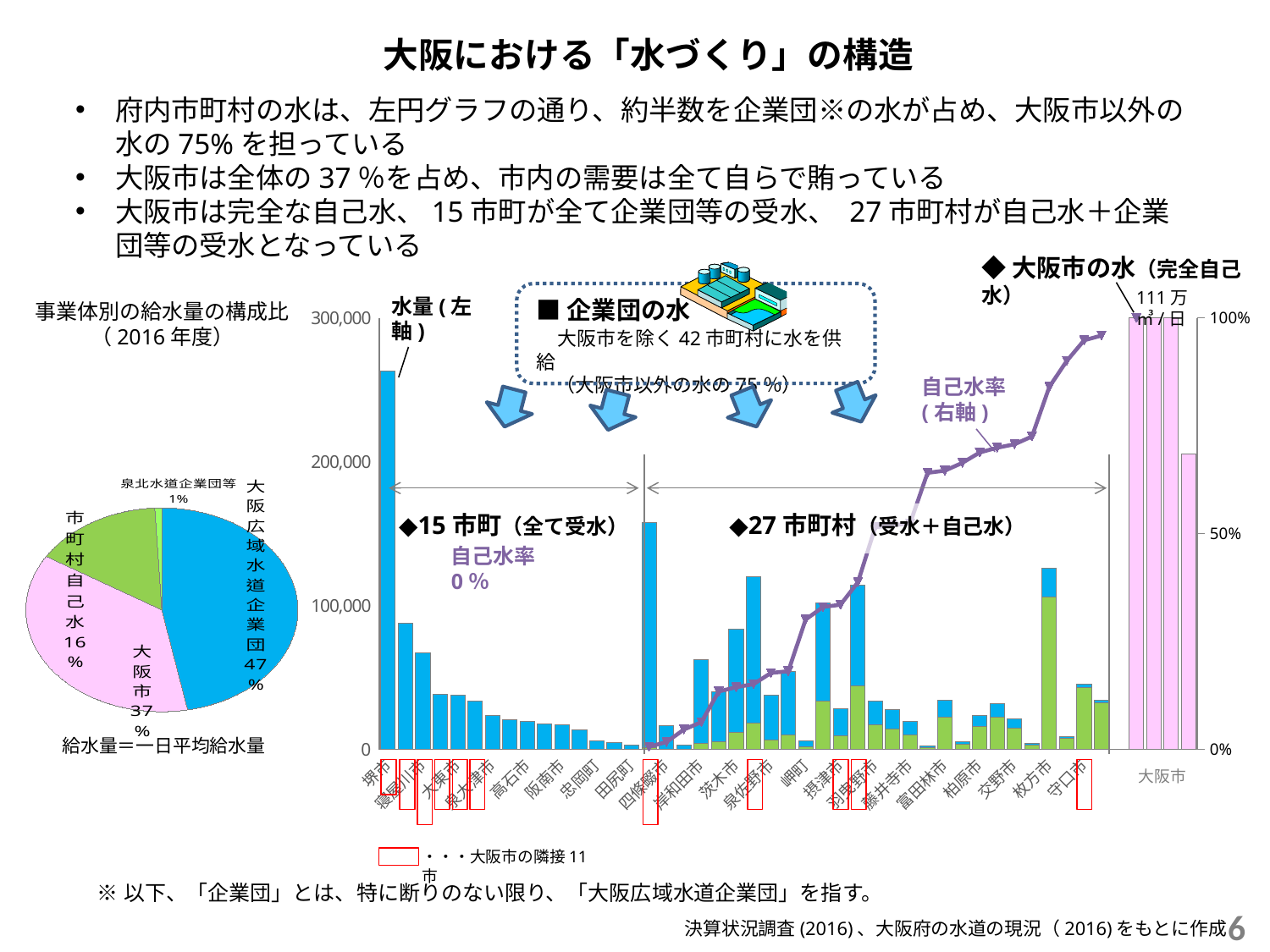
In the pie chart 事業体別の給水量の構成比, which slice is the smallest? 泉北水道企業団等 In the bar chart on the right, is the 水量 value for 堺市 greater or less than 200,000? greater In the pie chart 事業体別の給水量の構成比, what share does 市町村自己水 hold? 16% In the bar chart on the right, is the 水量 value for 高石市 greater or less than 100,000? less In the pie chart 事業体別の給水量の構成比, which slice is the largest? 大阪広域水道企業団 In the pie chart 事業体別の給水量の構成比, what share does 大阪市 hold? 37% In the pie chart 事業体別の給水量の構成比, what is the difference between the 大阪市 share and the 市町村自己水 share? 21% In the pie chart 事業体別の給水量の構成比, what share does 大阪広域水道企業団 hold? 47% In the bar chart on the right, which has the larger 水量 bar, 堺市 or 高石市? 堺市 In the bar chart on the right, does the 自己水率 line rise or fall from left to right across the 27 市町村 group? rise In the pie chart 事業体別の給水量の構成比, how many slices are there? 4 In the bar chart on the right, what is the 自己水率 for the 15 市町 group (全て受水)? 0%